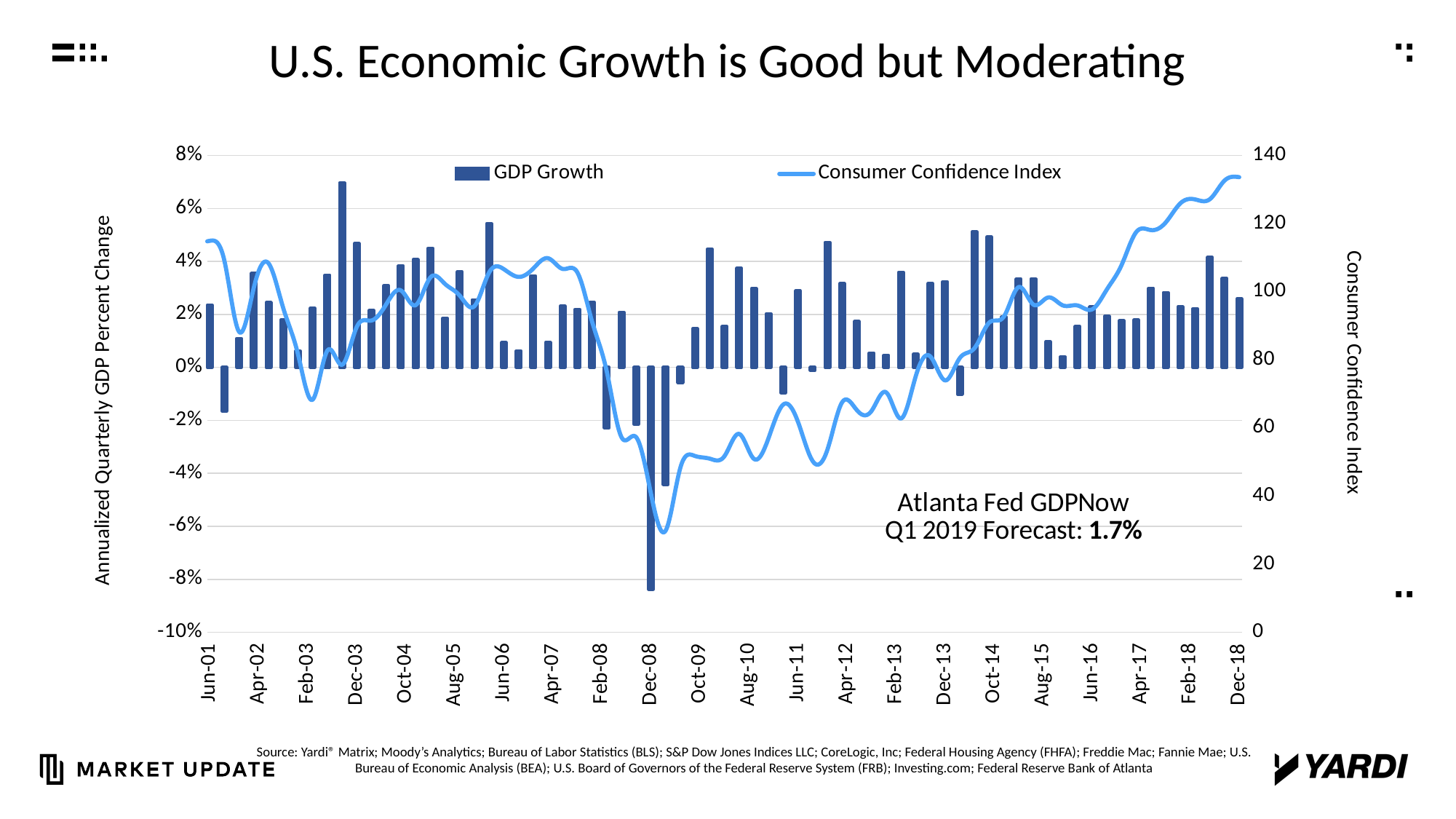
What is the title of the chart? U.S. Economic Growth is Good but Moderating Is the Consumer Confidence Index value at Jun-01 greater or less than 100? greater Around which x-axis label does GDP Growth reach its lowest value? Dec-08 How many series does the legend list? 2 Does the Consumer Confidence Index rise or fall between Jun-16 and Dec-18? rise Is the GDP Growth value at Dec-08 greater or less than -6%? less Which is higher, the Consumer Confidence Index at Dec-18 or at Jun-11? Dec-18 What kind of chart is shown on the slide? A combined bar and line chart Is the Consumer Confidence Index value at Dec-18 greater or less than 120? greater Which series is plotted as bars? GDP Growth Around which x-axis label does the Consumer Confidence Index reach its highest value? Dec-18